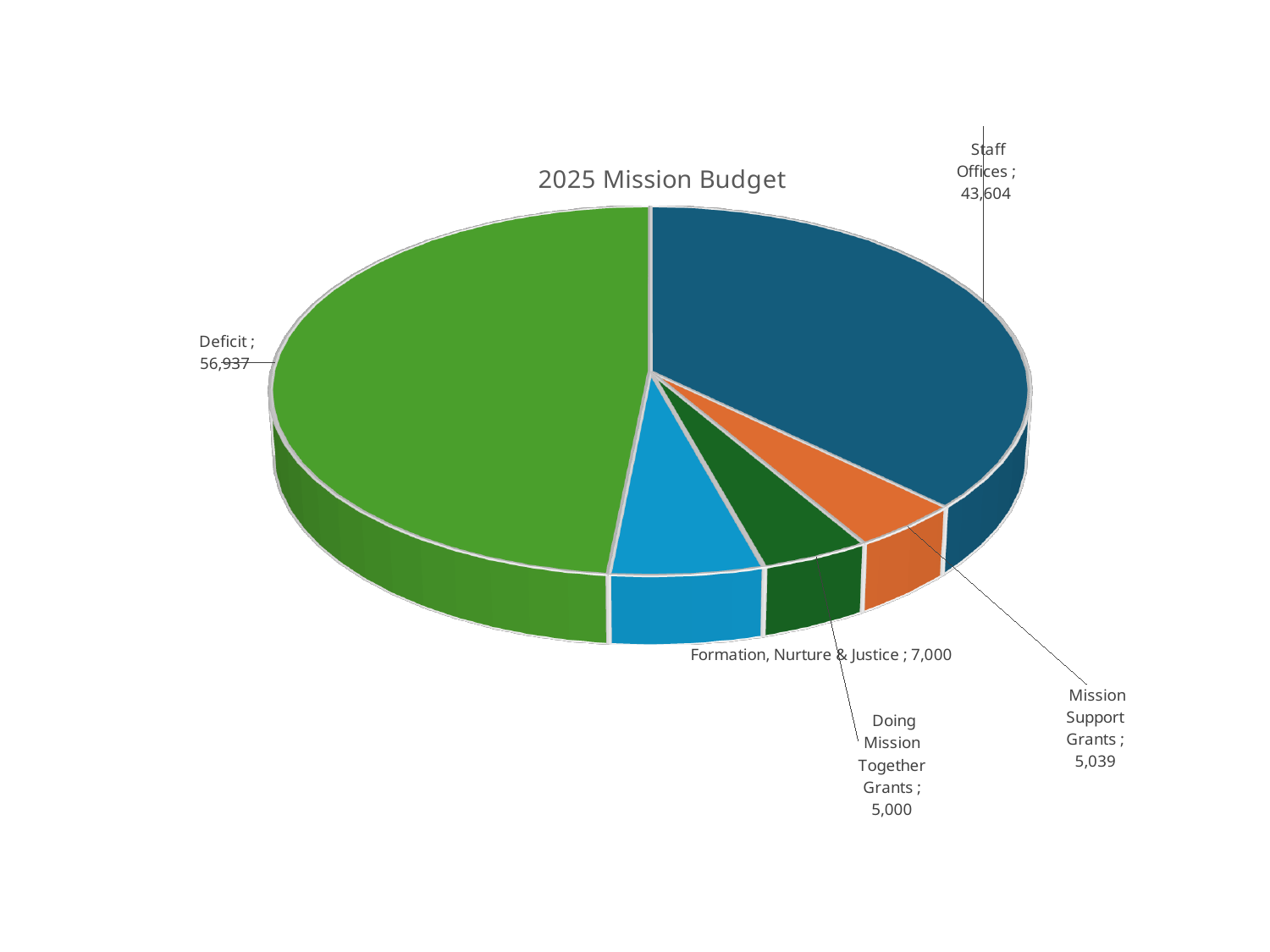
What is the value for Mission Support Grants? 5,039 Which category has the largest slice? Deficit What is the value for Formation, Nurture & Justice? 7,000 What is the value for Staff Offices? 43,604 What is the difference between Formation, Nurture & Justice and Doing Mission Together Grants? 2,000 Which category has the smallest value? Doing Mission Together Grants What is the difference between Deficit and Staff Offices? 13,333 How many slices does the pie chart have? 5 Which is larger, Staff Offices or Deficit? Deficit What is the title of the chart? 2025 Mission Budget What kind of chart is shown on the slide? pie chart What is the value for Deficit? 56,937